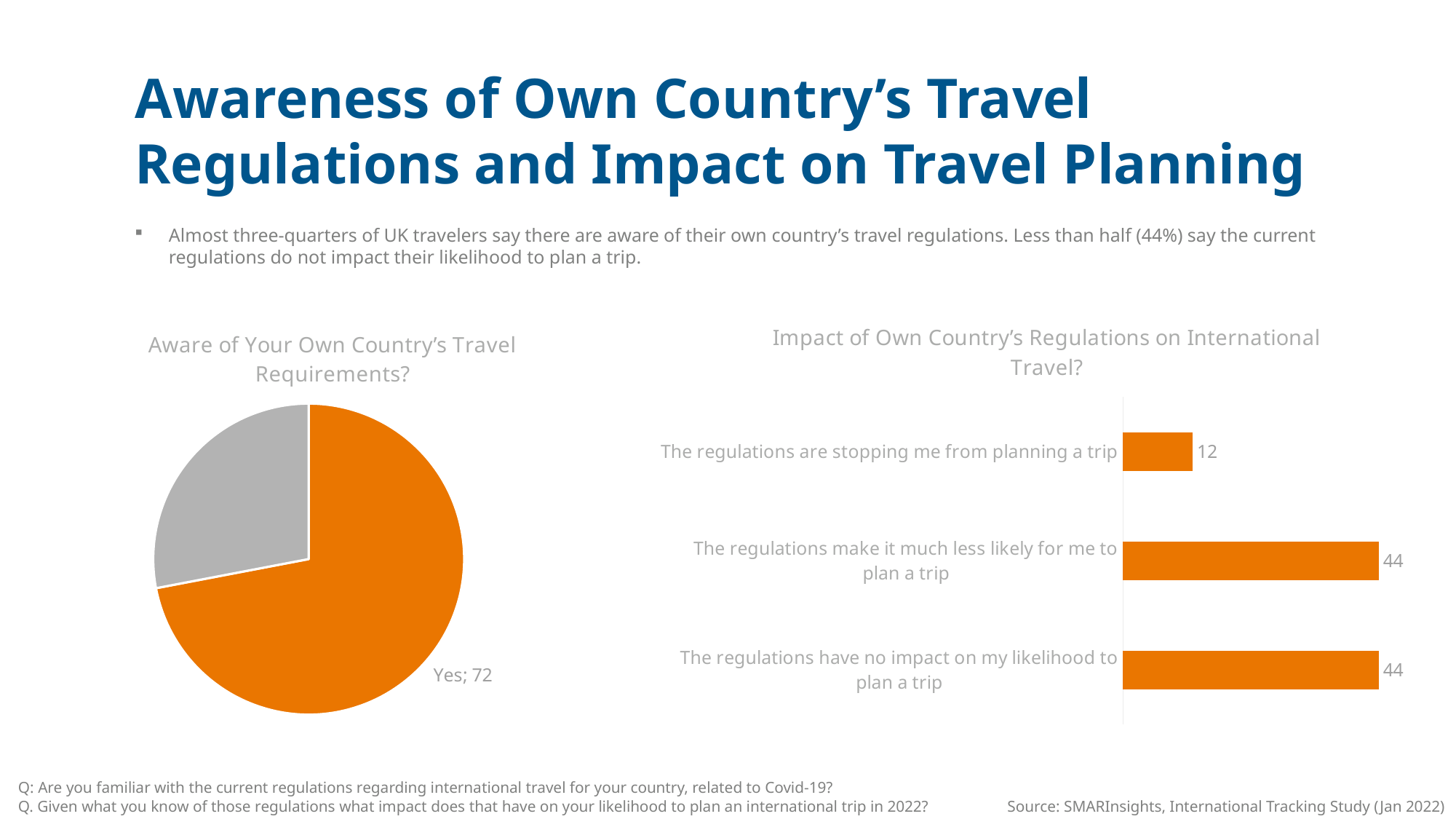
In the chart 'Impact of Own Country's Regulations on International Travel?', which is larger: the value for 'The regulations are stopping me from planning a trip' or the value for 'The regulations make it much less likely for me to plan a trip'? The regulations make it much less likely for me to plan a trip In the chart 'Impact of Own Country's Regulations on International Travel?', what is the value for 'The regulations make it much less likely for me to plan a trip'? 44 In the chart 'Impact of Own Country's Regulations on International Travel?', what is the difference between the value for 'The regulations have no impact on my likelihood to plan a trip' and the value for 'The regulations are stopping me from planning a trip'? 32 What kind of chart is the right chart titled 'Impact of Own Country's Regulations on International Travel?'? bar chart In the chart 'Impact of Own Country's Regulations on International Travel?', which category has the lowest value? The regulations are stopping me from planning a trip In the pie chart 'Aware of Your Own Country's Travel Requirements?', what value is shown for the 'Yes' slice? 72 What kind of chart is the left chart titled 'Aware of Your Own Country's Travel Requirements?'? pie chart In the chart 'Impact of Own Country's Regulations on International Travel?', what is the value for 'The regulations have no impact on my likelihood to plan a trip'? 44 In the pie chart 'Aware of Your Own Country's Travel Requirements?', what colour is the 'Yes' slice? orange How many categories are shown in the chart 'Impact of Own Country's Regulations on International Travel?'? 3 What is the title of the chart on the right side of the slide? Impact of Own Country's Regulations on International Travel? In the chart 'Impact of Own Country's Regulations on International Travel?', what is the value for 'The regulations are stopping me from planning a trip'? 12